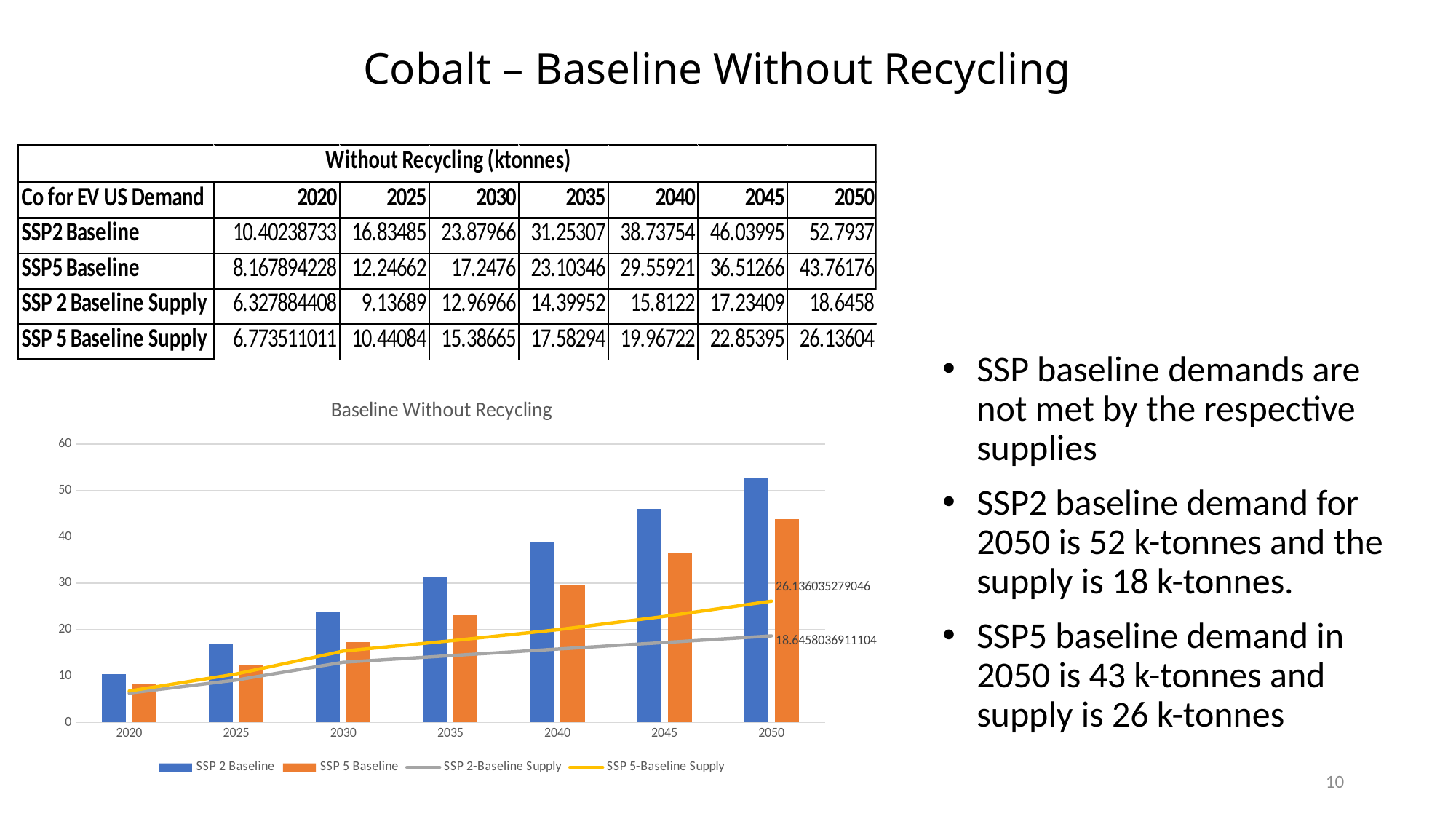
In the 'Baseline Without Recycling' chart, is the SSP 2 Baseline value for 2050 greater or less than 50? greater In the 'Baseline Without Recycling' chart, is the SSP 5 Baseline value for 2045 greater or less than 40? less In the 'Baseline Without Recycling' chart, what is the labelled value of SSP 5-Baseline Supply in 2050? 26.136035279046 In the 'Baseline Without Recycling' chart, which year has the highest SSP 2 Baseline bar? 2050 In the 'Baseline Without Recycling' chart, do the SSP 2 Baseline bars rise or fall from 2020 to 2050? rise In the 'Baseline Without Recycling' chart, which is larger in 2040: SSP 2 Baseline or SSP 5 Baseline? SSP 2 Baseline How many series does the legend of the 'Baseline Without Recycling' chart list? 4 What kind of chart is 'Baseline Without Recycling'? bar chart with line series In the 'Baseline Without Recycling' chart, which year has the lowest SSP 2 Baseline bar? 2020 How many years are shown on the x axis of the 'Baseline Without Recycling' chart? 7 In the 'Baseline Without Recycling' chart, what is the labelled value of SSP 2-Baseline Supply in 2050? 18.6458036911104 In the 'Baseline Without Recycling' chart, which line is higher in 2050: SSP 2-Baseline Supply or SSP 5-Baseline Supply? SSP 5-Baseline Supply